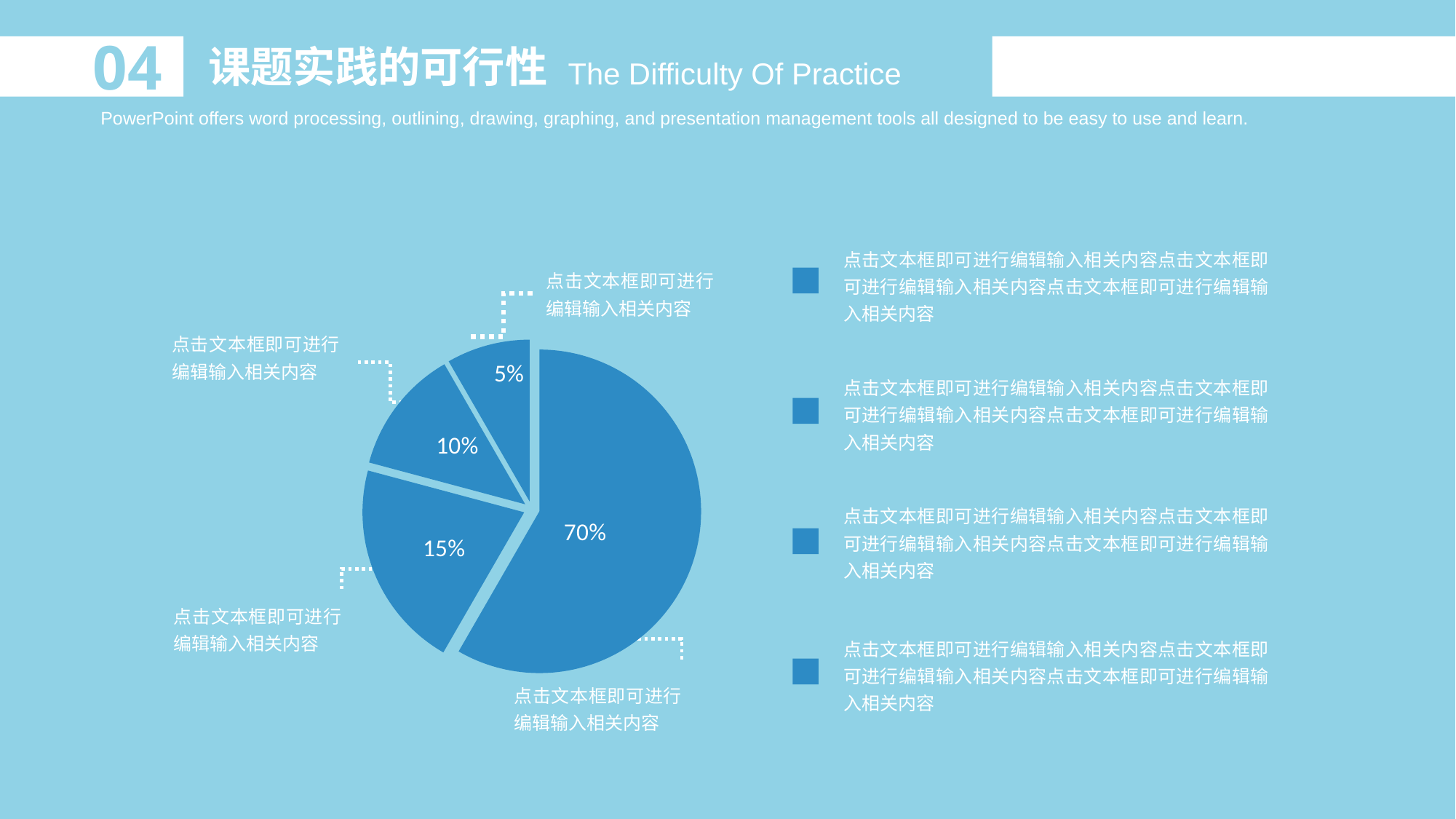
What is the difference between the 15% slice and the 10% slice in the pie chart? 5% What is the section number shown at the top left of the slide? 04 What is the second-largest value shown in the pie chart? 15% What is the value of the smallest slice in the pie chart? 5% What is the value of the largest slice in the pie chart? 70% Is the largest slice of the pie chart greater or less than 50%? greater Which is larger in the pie chart, the slice labelled 10% or the slice labelled 15%? 15% What is the difference between the largest slice and the smallest slice in the pie chart? 65% What is the combined value of the three smallest slices in the pie chart? 30% What is the English subtitle of the slide containing the pie chart? The Difficulty Of Practice What kind of chart is shown on the slide? pie chart How many slices does the pie chart have? 4